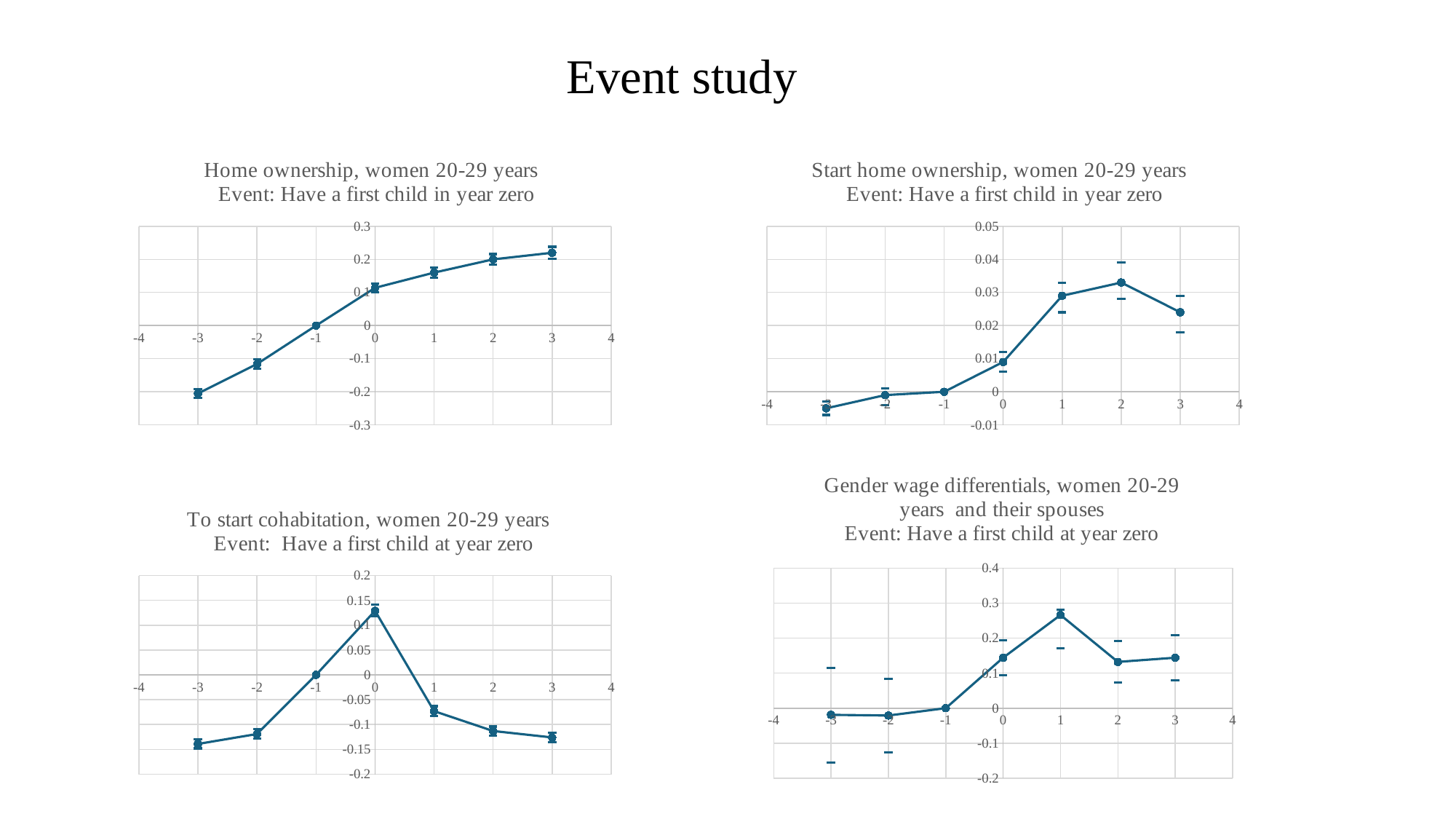
In the 'To start cohabitation, women 20-29 years' chart, which year has the highest value? 0 In the 'Home ownership, women 20-29 years' chart, do the values rise or fall from year -3 to year 3? rise In the 'To start cohabitation, women 20-29 years' chart, is the value at year 1 greater or less than 0? less What kind of chart is the 'Home ownership, women 20-29 years' chart? line chart In the 'Gender wage differentials' chart, is the value at year 1 greater or less than 0.2? greater In the 'Start home ownership, women 20-29 years' chart, which year has the highest value? 2 In the 'Start home ownership, women 20-29 years' chart, is the value at year 1 greater or less than 0.02? greater In the 'Home ownership, women 20-29 years' chart, how many data points are plotted? 7 How many charts are shown on the slide? 4 In the 'Home ownership, women 20-29 years' chart, which year has the lowest value? -3 In the 'Home ownership, women 20-29 years' chart, what is the value at year -1? 0